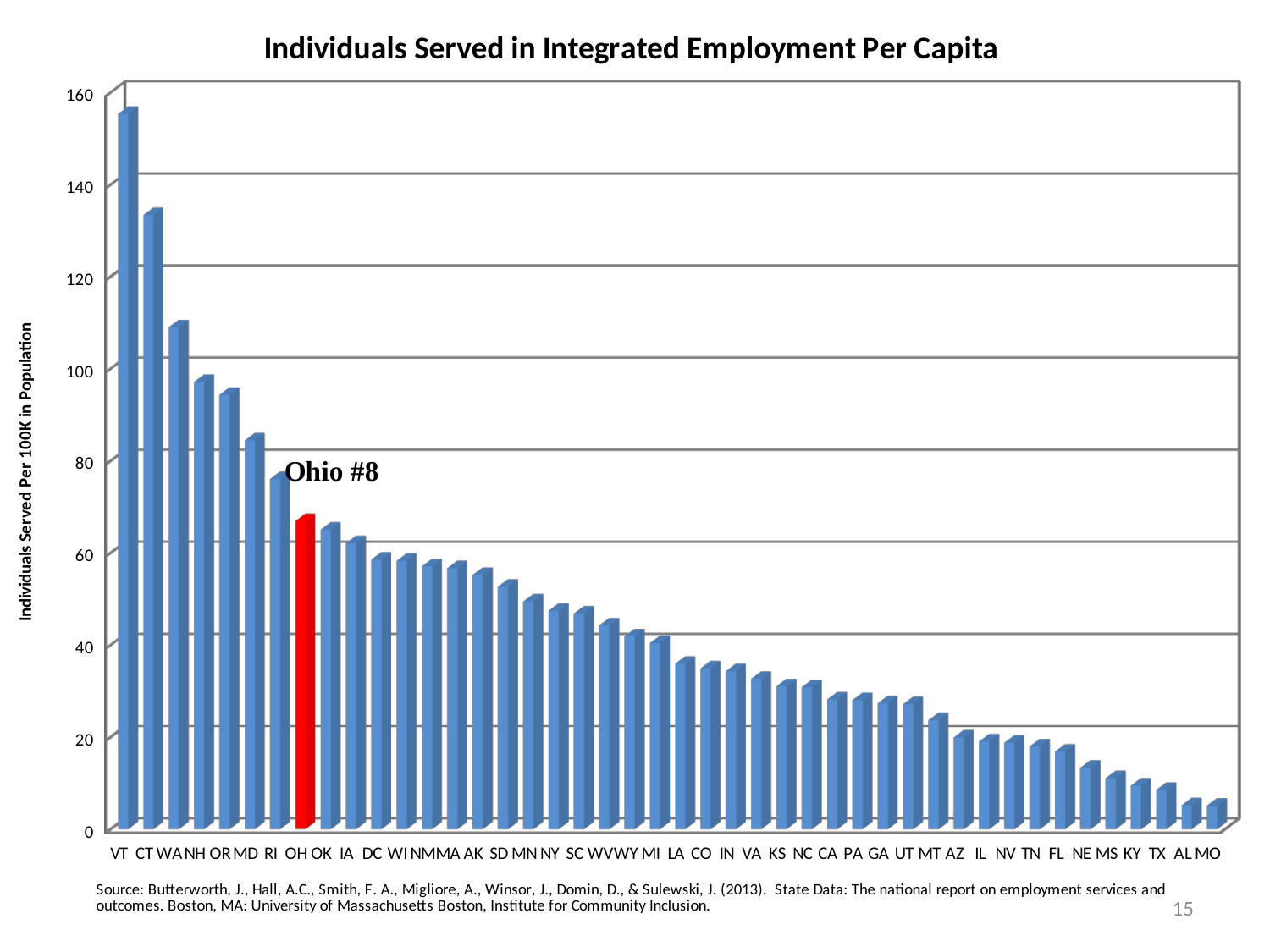
What is the title of the chart? Individuals Served in Integrated Employment Per Capita Which state's bar is highlighted in red? OH Is the value for OH greater or less than 60? greater Which state has the highest value in the chart? VT Do the values rise or fall moving from left to right along the x axis? fall Is the value for CT greater or less than 120? greater How many states or jurisdictions are shown as bars in the chart? 44 Is the value for WA greater or less than 100? greater Which has a larger value, RI or OH? RI What type of chart is shown on the slide? bar chart